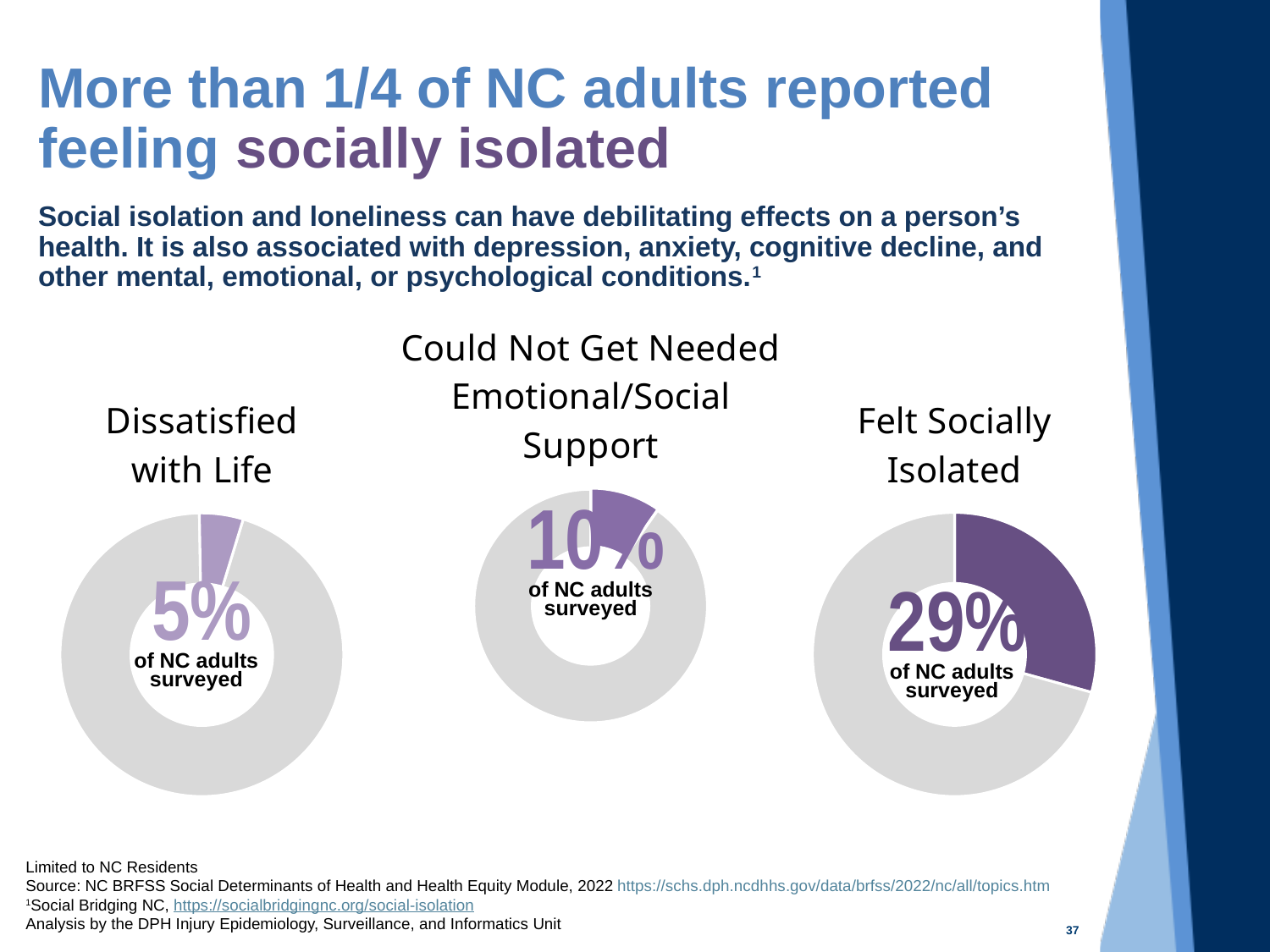
What is the difference in percentage points between the 'Felt Socially Isolated' chart and the 'Could Not Get Needed Emotional/Social Support' chart? 19 In the 'Could Not Get Needed Emotional/Social Support' chart, what percentage of NC adults surveyed is shown? 10% Which is larger: the percentage in the 'Could Not Get Needed Emotional/Social Support' chart or the percentage in the 'Dissatisfied with Life' chart? Could Not Get Needed Emotional/Social Support How many donut charts are shown on the slide? 3 Across the three charts on the slide, which indicator has the lowest percentage? Dissatisfied with Life What is the title of the middle chart on the slide? Could Not Get Needed Emotional/Social Support Across the three charts on the slide, which indicator has the highest percentage? Felt Socially Isolated In the 'Felt Socially Isolated' chart, what percentage of NC adults surveyed is shown? 29% In the 'Dissatisfied with Life' chart, what percentage of NC adults surveyed is shown? 5% What is the difference in percentage points between the 'Felt Socially Isolated' chart and the 'Dissatisfied with Life' chart? 24 What kind of chart is used to show the 'Felt Socially Isolated' value? Donut (pie) chart What text appears below the percentage inside each donut chart? of NC adults surveyed